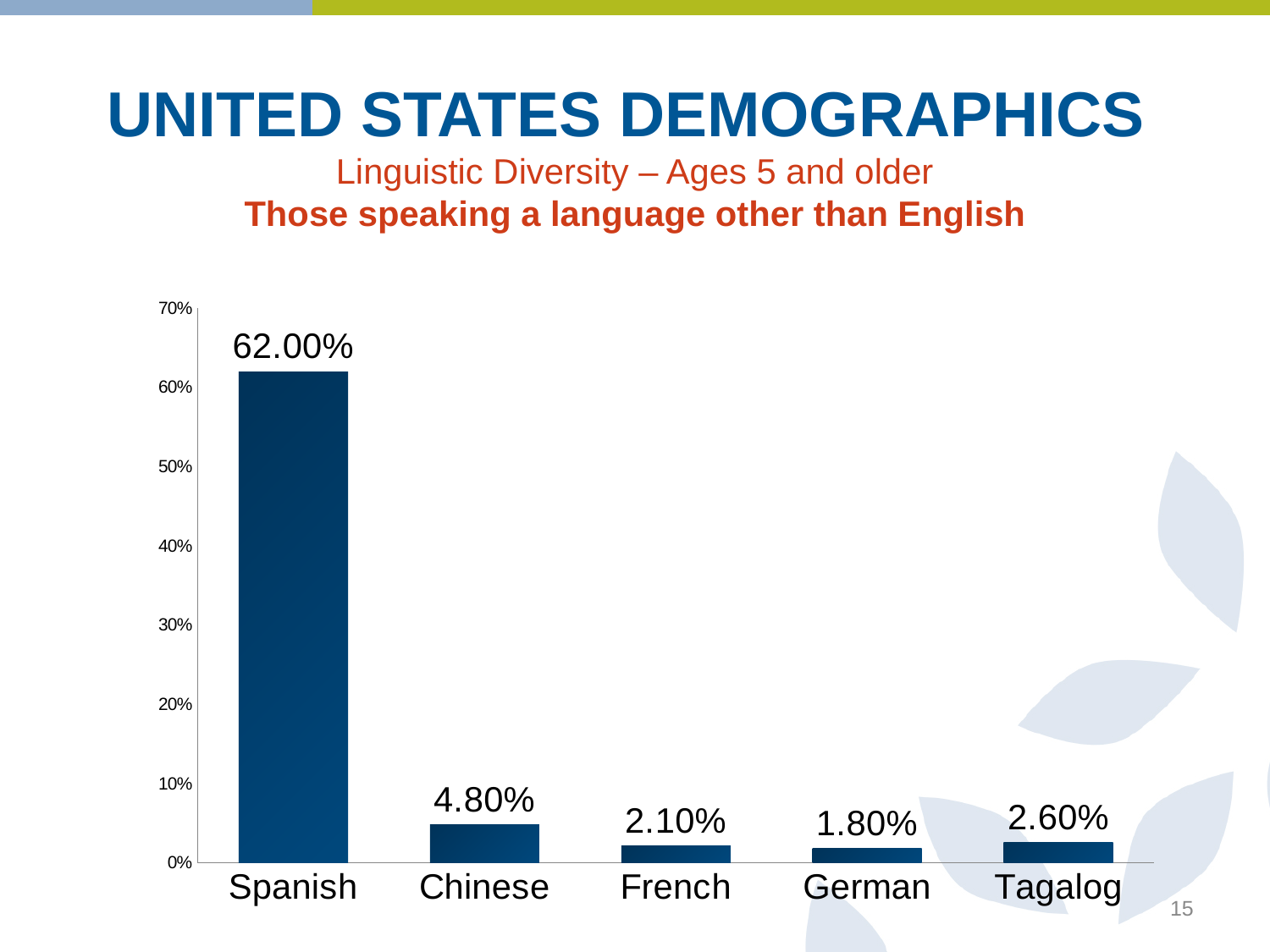
What is the value for French? 2.10% How many languages are shown on the chart? 5 What is the value for Chinese? 4.80% What is the value for Spanish? 62.00% What kind of chart is shown on the slide? bar chart Is the value for Spanish greater or less than 60%? greater Which is larger, the value for Tagalog or the value for French? Tagalog What is the value for German? 1.80% What is the difference between the values for Spanish and Chinese? 57.20% What is the value for Tagalog? 2.60% Which language has the highest value? Spanish Which language has the lowest value? German